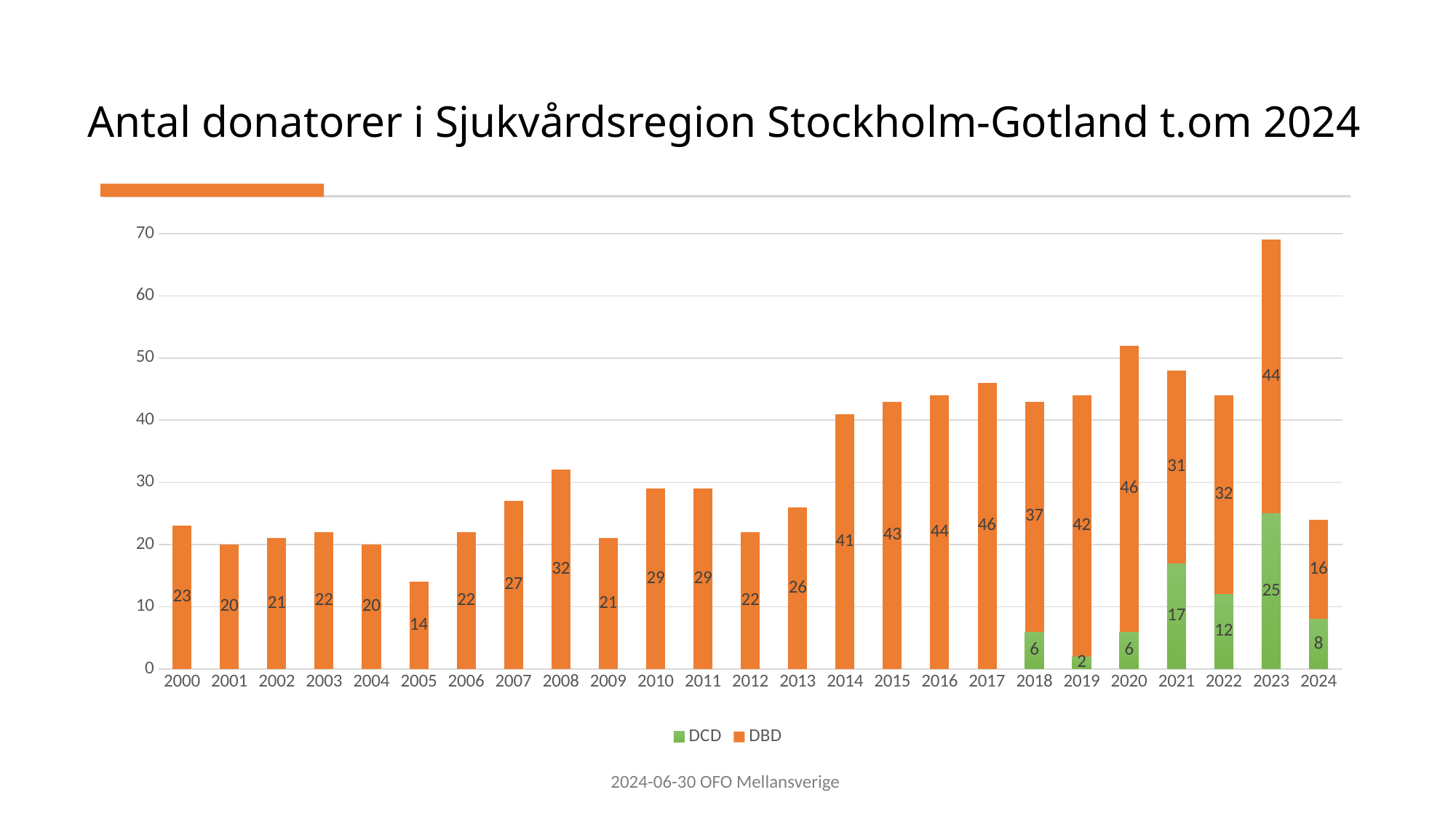
Which is larger, the DCD value for 2022 or the DCD value for 2024? 2022 How many years are shown on the x axis? 25 What type of chart is shown on the slide? Stacked bar chart How many series does the legend list? 2 What is the DBD value for 2023? 44 Which series is shown in green in the legend? DCD Which year has the highest DCD value? 2023 Which year has the lowest DBD value? 2005 What is the total number of donors in 2023 (DCD plus DBD)? 69 What is the difference between the DBD values for 2017 and 2018? 9 What is the DCD value for 2021? 17 What is the DBD value for 2005? 14